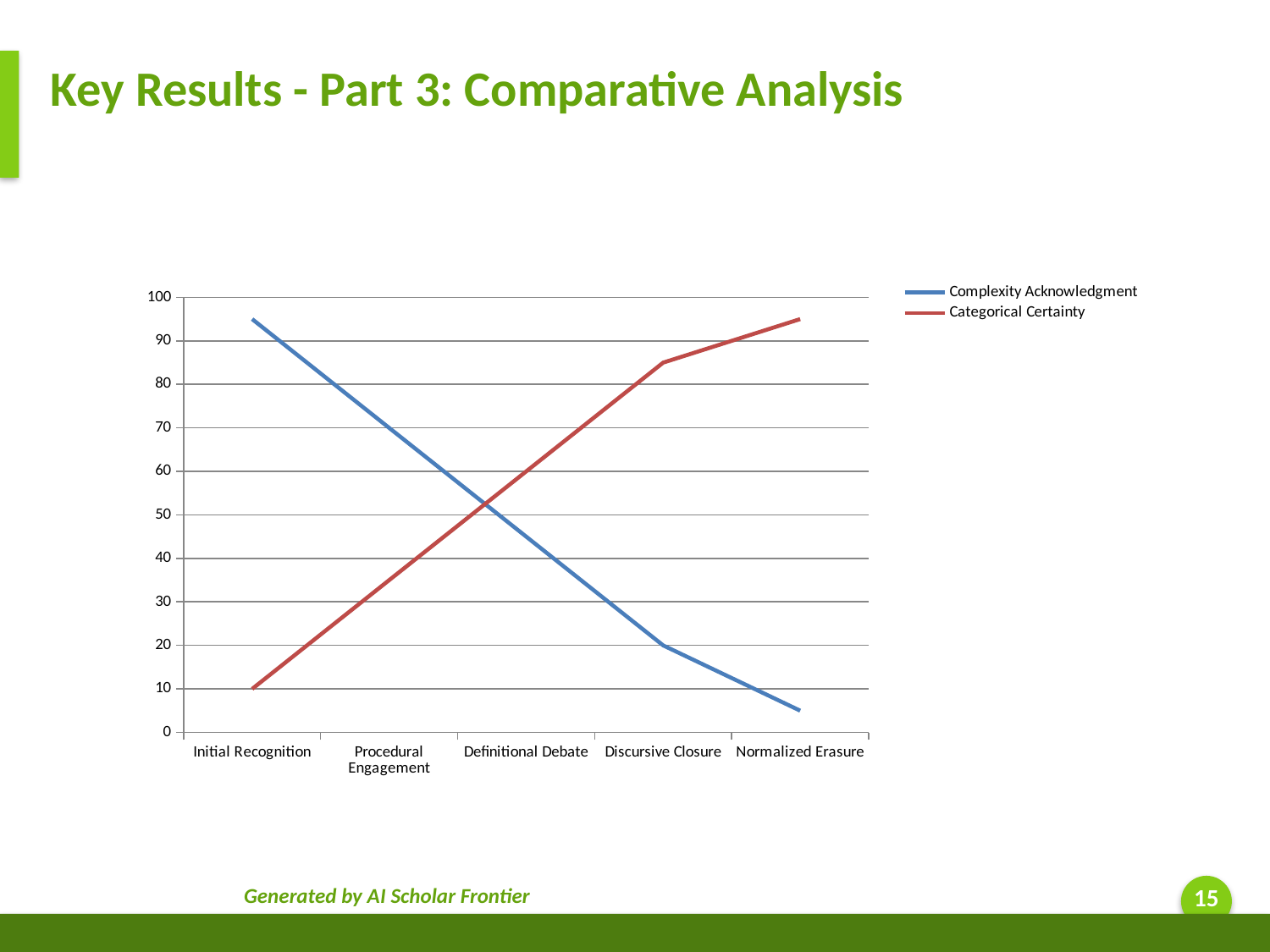
At which category is Categorical Certainty lowest? Initial Recognition Is the value for Complexity Acknowledgment at Normalized Erasure greater or less than 10? less At which category is Complexity Acknowledgment highest? Initial Recognition Does the Complexity Acknowledgment line rise or fall from Initial Recognition to Normalized Erasure? fall How many series does the legend list? 2 How many categories are shown on the x axis? 5 At Procedural Engagement, which series has the larger value, Complexity Acknowledgment or Categorical Certainty? Complexity Acknowledgment At Discursive Closure, which series has the larger value, Complexity Acknowledgment or Categorical Certainty? Categorical Certainty What kind of chart is shown on the slide? line chart Is the value for Categorical Certainty at Discursive Closure greater or less than 80? greater Which series is drawn in red? Categorical Certainty Does the Categorical Certainty line rise or fall from Initial Recognition to Normalized Erasure? rise